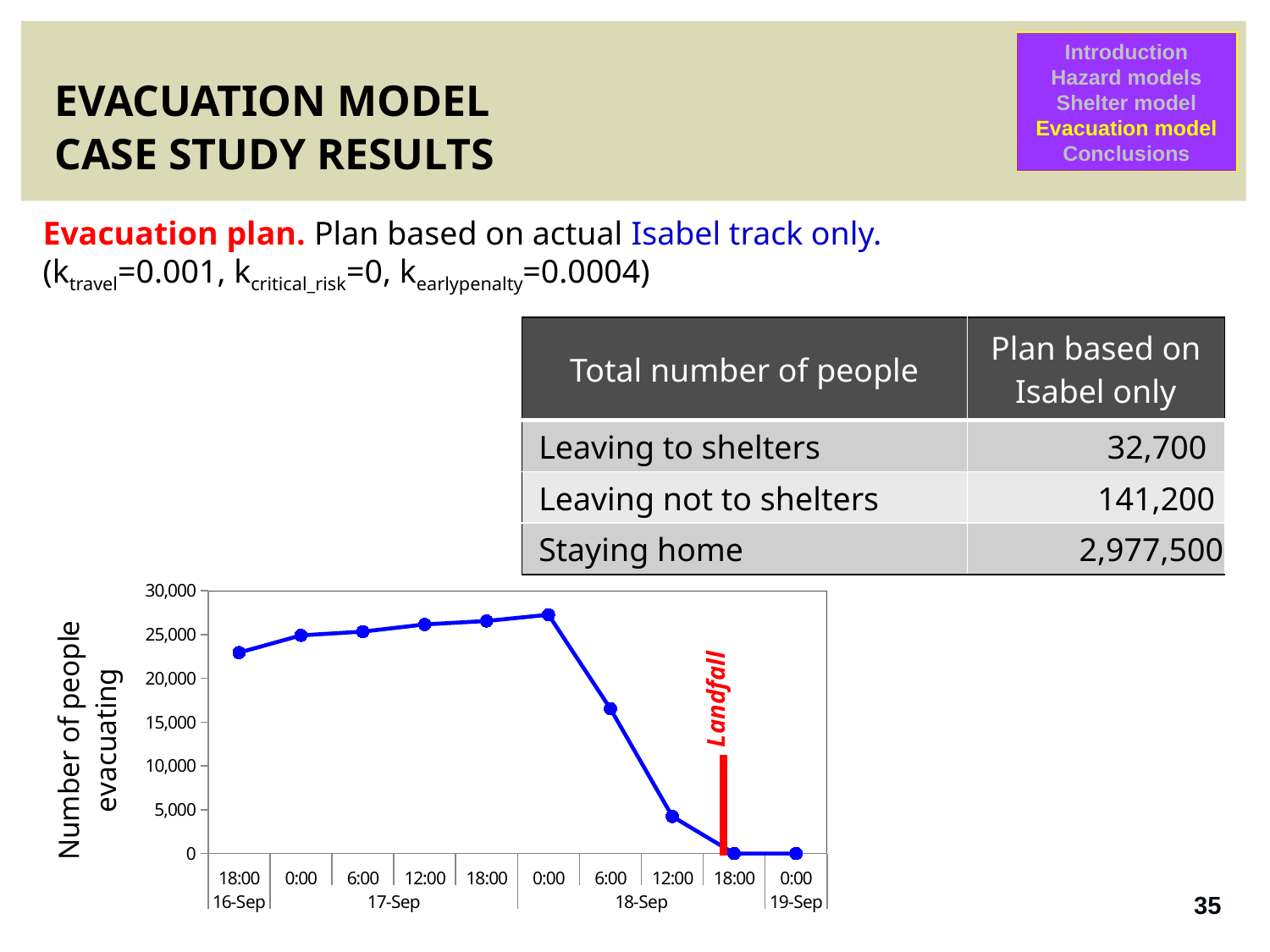
At which time does the line chart reach its highest value? 0:00 on 18-Sep What kind of chart is shown at the bottom of the slide? line chart How many data points are plotted on the line chart? 10 Is the number of people evacuating at 18:00 on 16-Sep greater or less than 25,000? less Is the number of people evacuating at 6:00 on 18-Sep greater or less than 15,000? greater Is the number of people evacuating at 12:00 on 18-Sep greater or less than 5,000? less What event does the red vertical line on the chart mark? Landfall What value does the line reach at 18:00 on 18-Sep? 0 Which is larger: the number of people evacuating at 18:00 on 16-Sep or at 6:00 on 18-Sep? 18:00 on 16-Sep What is the label on the vertical axis of the chart? Number of people evacuating Does the number of people evacuating rise or fall between 0:00 and 18:00 on 18-Sep? fall